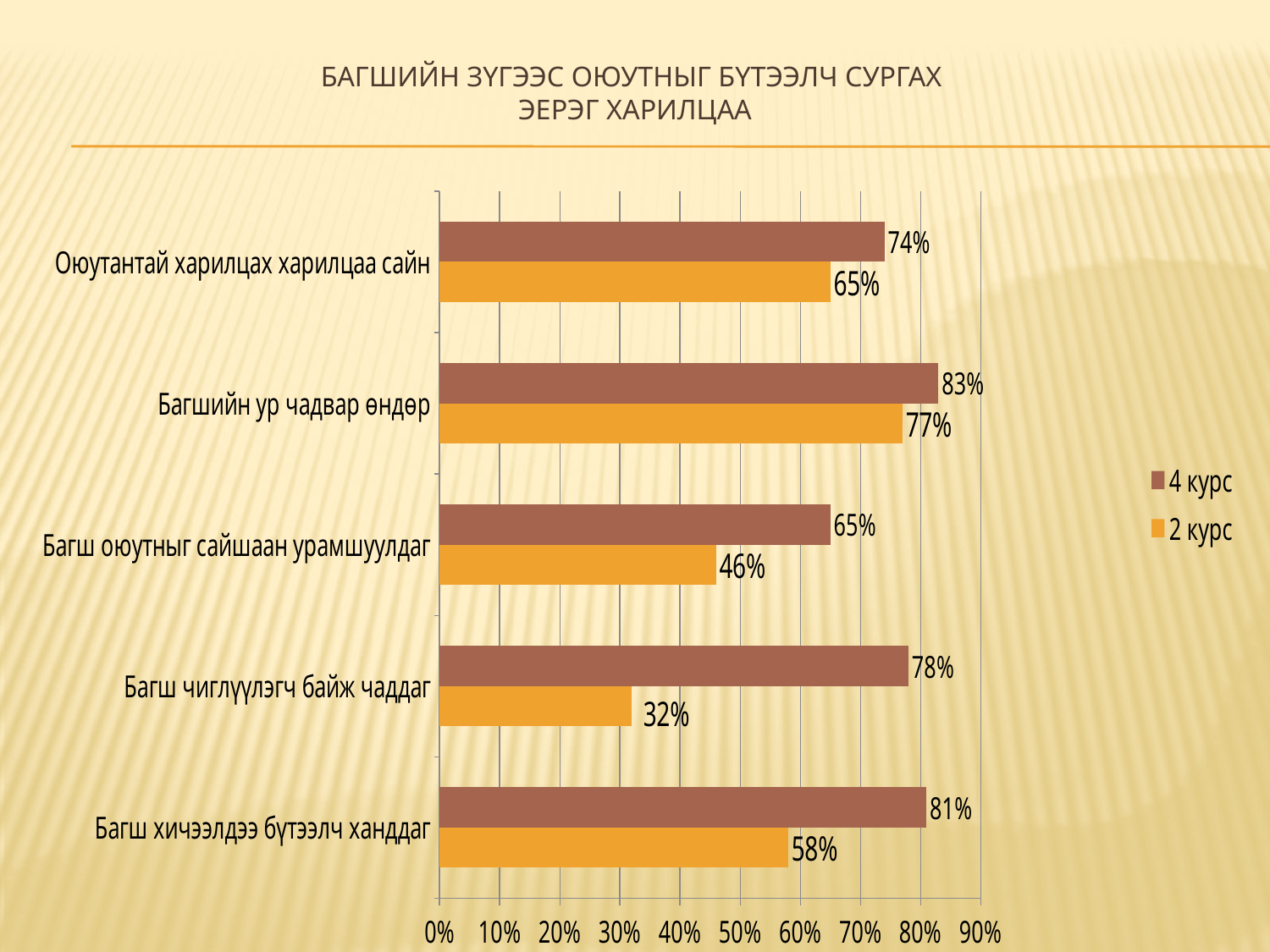
Which is larger: the "2 курс" value for "Багшийн ур чадвар өндөр" or the "2 курс" value for "Оюутантай харилцах харилцаа сайн"? Багшийн ур чадвар өндөр What is the value for "2 курс" in the category "Багш хичээлдээ бүтээлч ханддаг"? 58% What is the value for "4 курс" in the category "Багшийн ур чадвар өндөр"? 83% How many series does the legend list? 2 How many categories are shown on the chart? 5 Which category has the lowest value for "2 курс"? Багш чиглүүлэгч байж чаддаг What is the value for "2 курс" in the category "Багш чиглүүлэгч байж чаддаг"? 32% Which series is shown in orange in the legend? 2 курс Which category has the highest value for "4 курс"? Багшийн ур чадвар өндөр What is the difference between the "4 курс" and "2 курс" values for "Оюутантай харилцах харилцаа сайн"? 9% What kind of chart is shown on the slide? Bar chart What is the difference between the "4 курс" and "2 курс" values for "Багш чиглүүлэгч байж чаддаг"? 46%